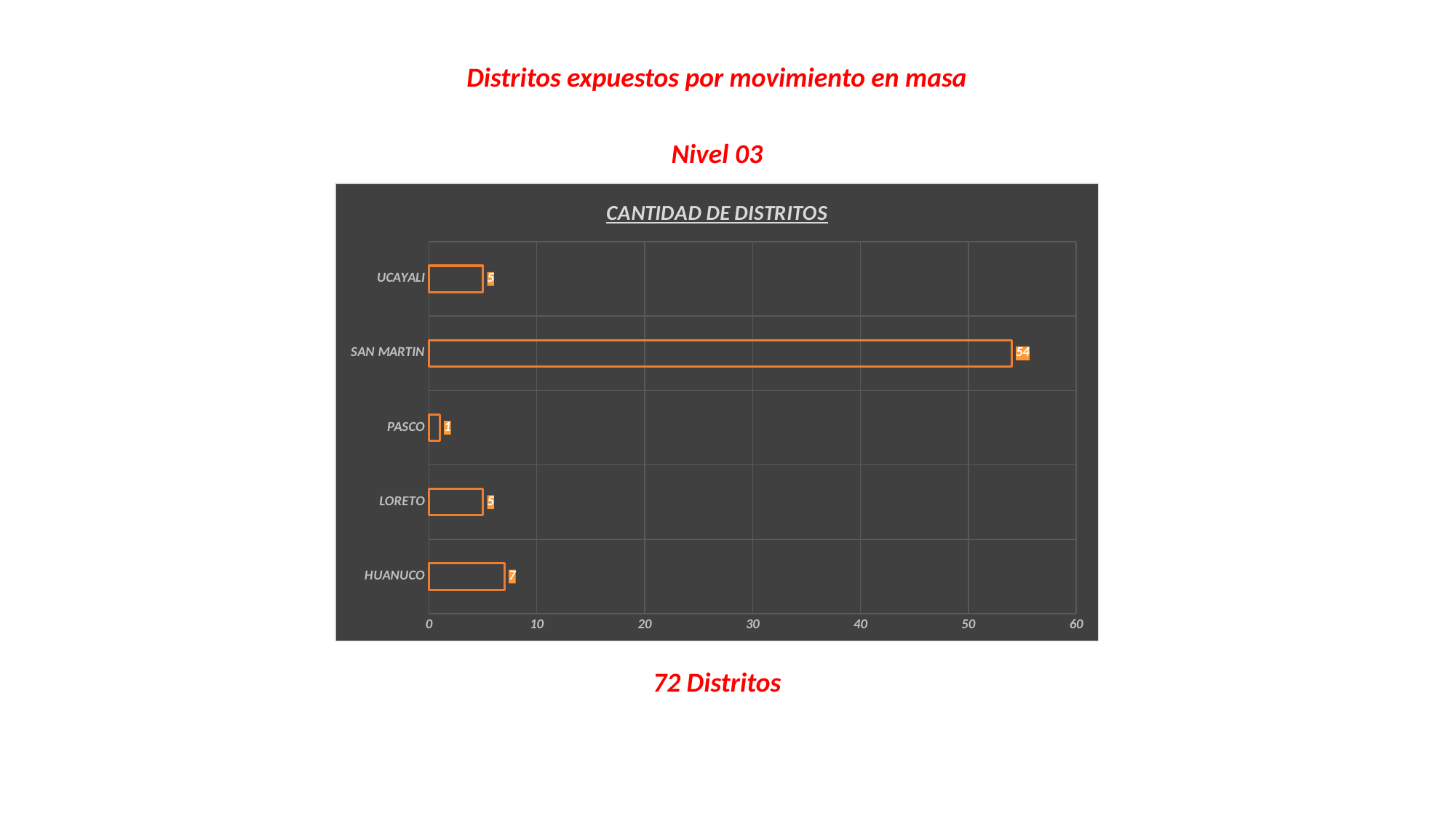
What is the difference between the values for SAN MARTIN and HUANUCO? 47 What kind of chart is shown? bar chart What is the value for SAN MARTIN? 54 How many categories are shown in the chart? 5 Which is larger, the value for HUANUCO or the value for LORETO? HUANUCO What is the value for PASCO? 1 Is the value for SAN MARTIN greater or less than 50? greater What is the title of the chart? CANTIDAD DE DISTRITOS Which category has the lowest value? PASCO Which category has the highest value? SAN MARTIN What is the value for HUANUCO? 7 What is the difference between the values for UCAYALI and PASCO? 4